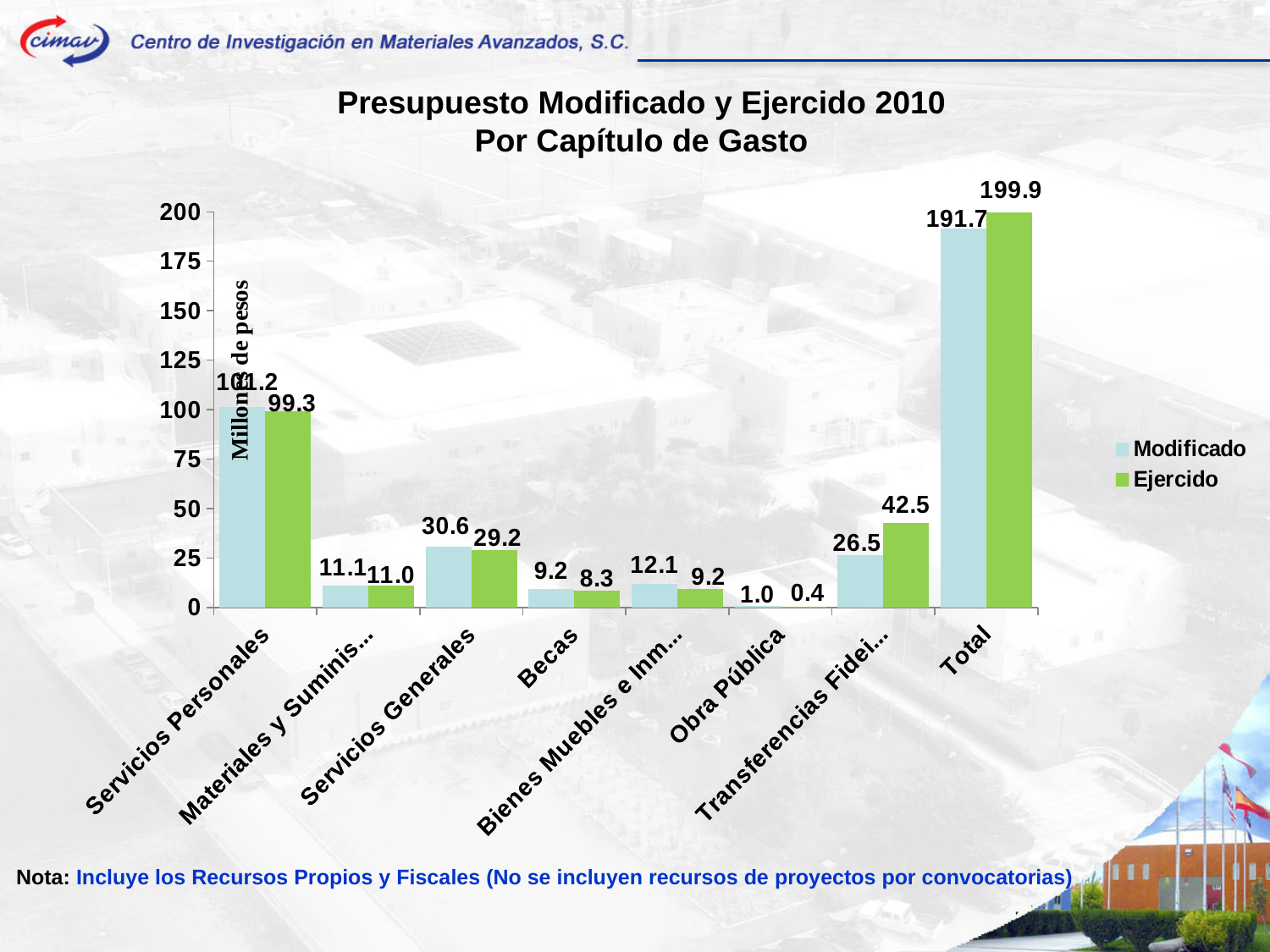
What type of chart is shown on the slide? bar chart How many categories are shown on the x axis? 8 What is the label of the vertical axis? Millones de pesos Excluding Total, which category has the lowest Ejercido value? Obra Pública What is the Ejercido value for Total? 199.9 How many series does the legend list? 2 What is the Ejercido value for Servicios Generales? 29.2 Which is larger for Total, the Modificado value or the Ejercido value? Ejercido What is the Modificado value for Becas? 9.2 What is the Modificado value for Transferencias Fidei...? 26.5 What is the difference between the Ejercido and Modificado values for Transferencias Fidei...? 16.0 What is the difference between the Modificado and Ejercido values for Bienes Muebles e Inm...? 2.9